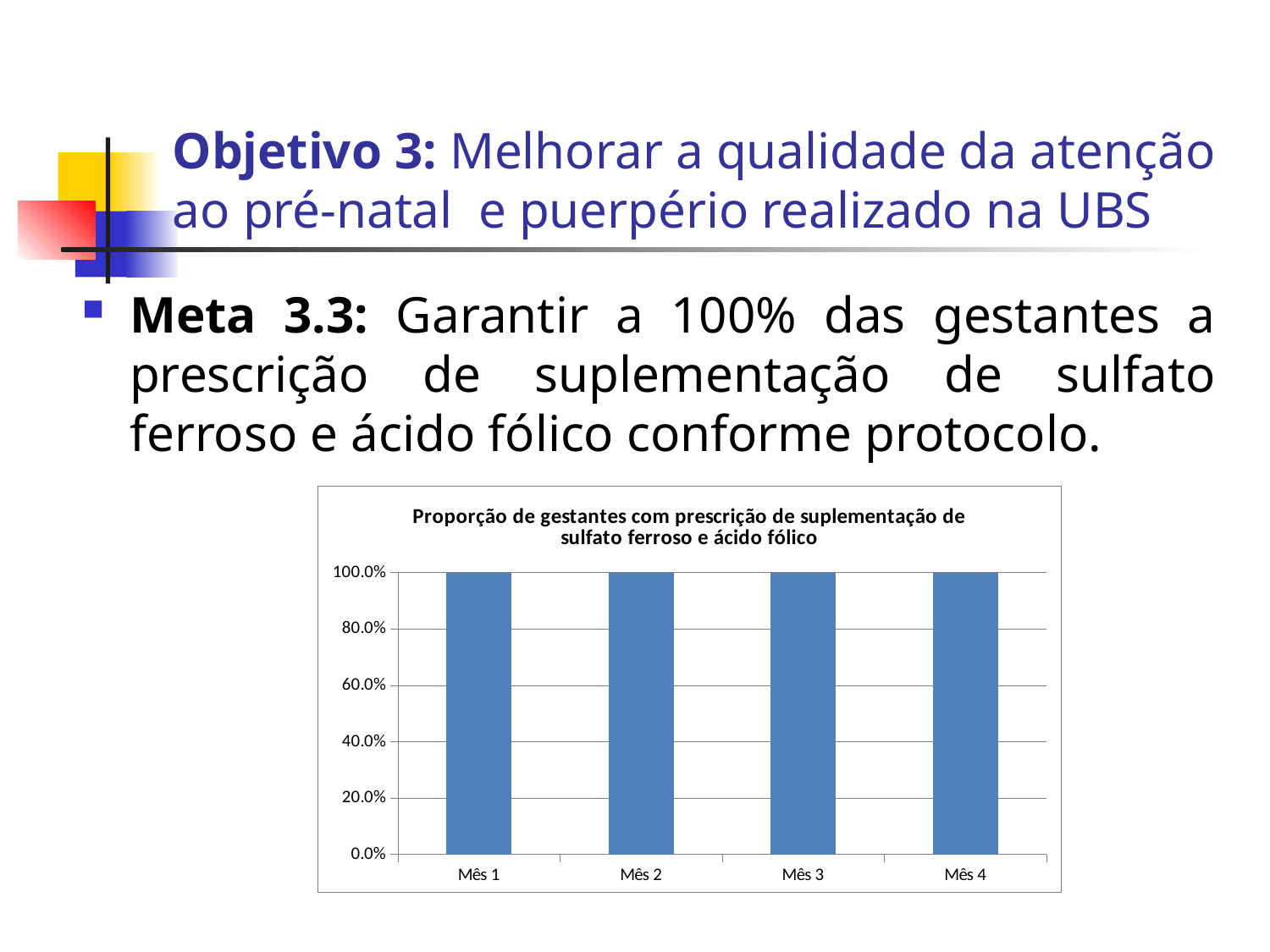
What is the value for Mês 4 in the chart? 100.0% What is the value for Mês 1 in the chart? 100.0% What is the value for Mês 3 in the chart? 100.0% How many months (categories) are plotted on the x axis of the chart? 4 What is the difference between the values for Mês 1 and Mês 4? 0.0% Is the value for Mês 1 greater or less than 60.0%? greater What is the value for Mês 2 in the chart? 100.0% What is the title of the chart? Proporção de gestantes com prescrição de suplementação de sulfato ferroso e ácido fólico What kind of chart is shown on the slide? Bar chart Do the values rise, fall, or stay the same from Mês 1 to Mês 4? Stay the same What is the label of the first category on the x axis? Mês 1 Is the value for Mês 3 greater or less than 80.0%? greater